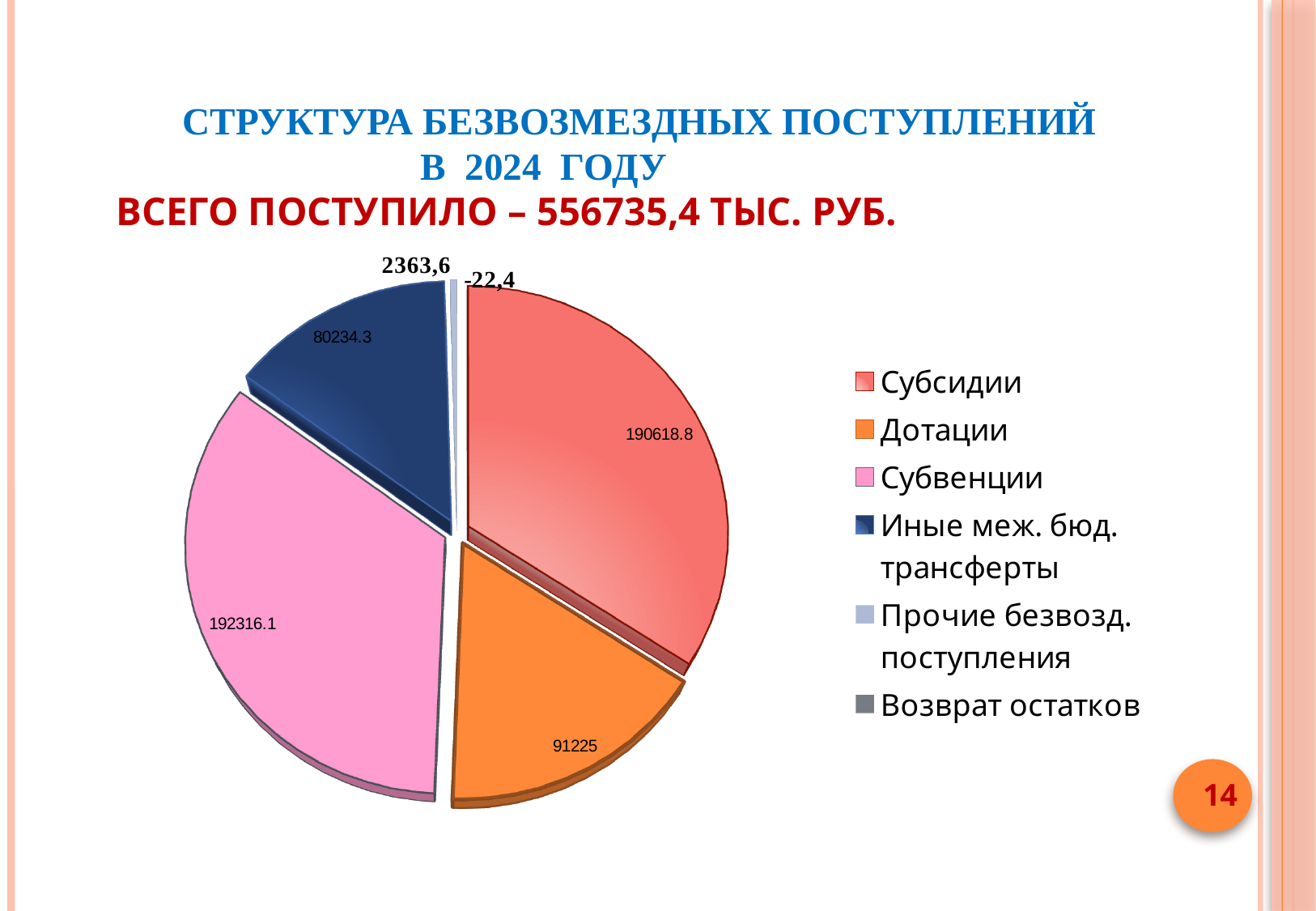
What is the difference between the values for Субсидии and Дотации? 99393.8 What is the value for Субсидии in the pie chart? 190618.8 What is the value for Субвенции in the pie chart? 192316.1 What kind of chart is shown on the slide? Pie chart Which category has the smallest value in the pie chart? Возврат остатков Which is larger, the value for Дотации or the value for Иные меж. бюд. трансферты? Дотации What is the value for Дотации in the pie chart? 91225 How many categories does the pie chart show? 6 What is the value for Иные меж. бюд. трансферты in the pie chart? 80234.3 Which category has the largest value in the pie chart? Субвенции What is the value for Прочие безвозд. поступления in the pie chart? 2363,6 What is the value for Возврат остатков in the pie chart? -22,4